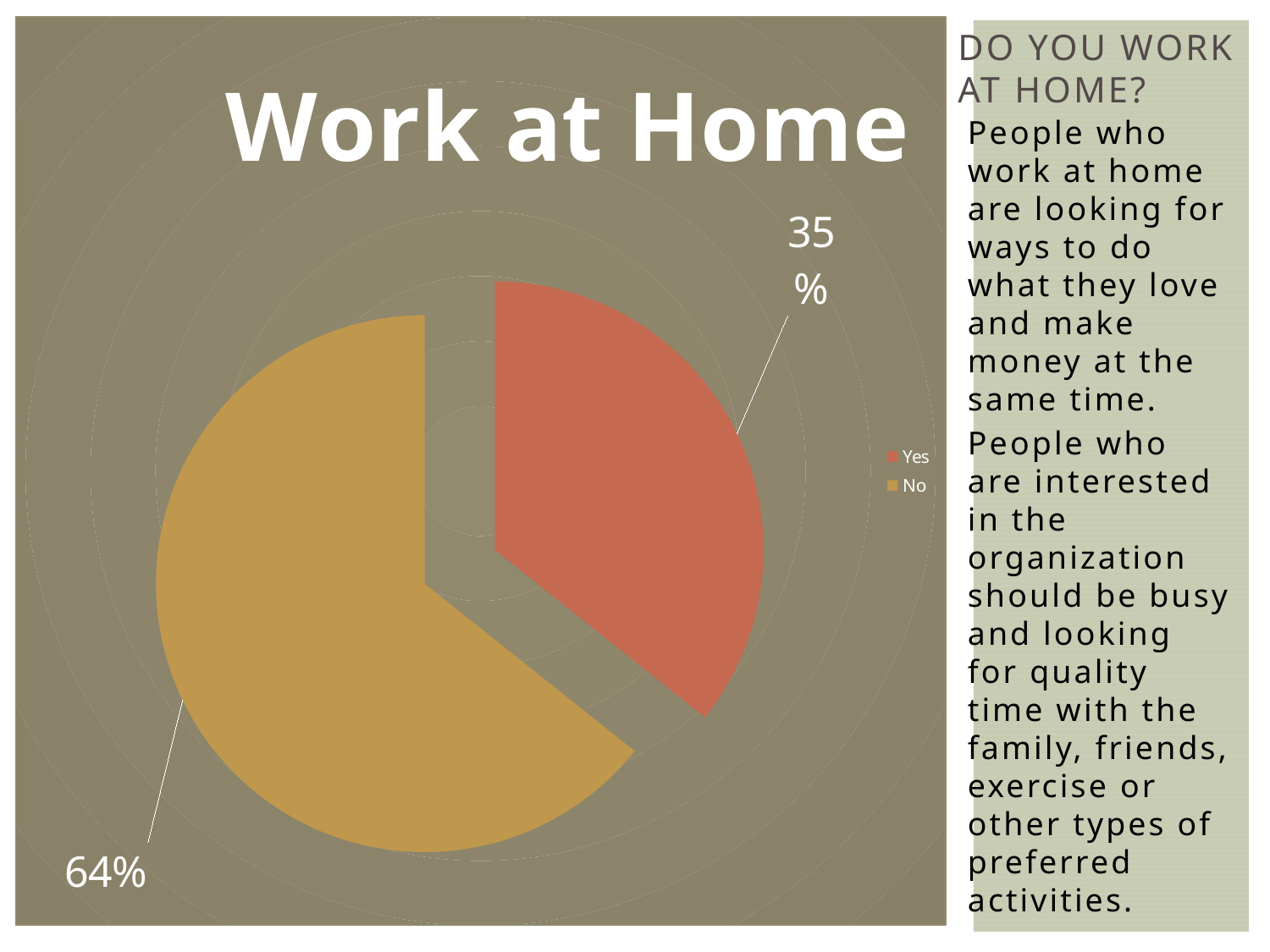
How many slices does the pie chart have? 2 What colour is the Yes slice in the pie chart? red Which is larger, the Yes slice or the No slice? No How many entries does the legend list? 2 What percentage of the pie is labelled for the No slice? 64% What kind of chart is shown on the slide? pie chart What is the difference in percentage points between the No slice and the Yes slice? 29 Which slice of the pie is the smallest? Yes What percentage of the pie is labelled for the Yes slice? 35% What is the title of the chart? Work at Home Is the share of the No slice greater or less than 50%? greater Which slice of the pie is the largest? No